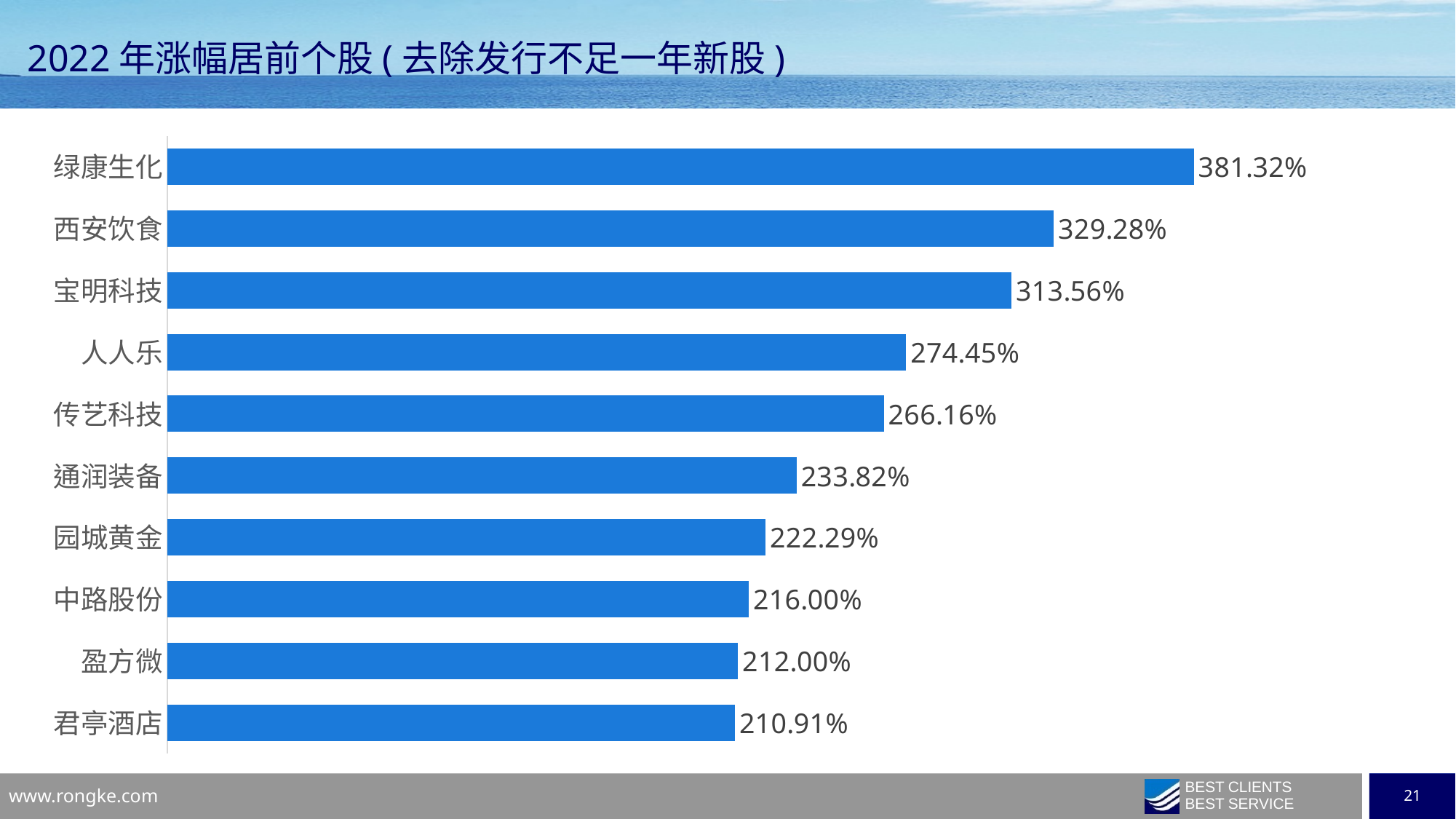
Which stock has the highest value? 绿康生化 What is the value for 君亭酒店? 210.91% Which stock has the lowest value? 君亭酒店 Which is larger, the value for 园城黄金 or the value for 宝明科技? 宝明科技 What kind of chart is shown on the slide? Bar chart What is the title of the chart? 2022 年涨幅居前个股（去除发行不足一年新股） What is the value for 绿康生化? 381.32% How many stocks are shown in the chart? 10 What is the value for 通润装备? 233.82% Which is larger, the value for 人人乐 or the value for 传艺科技? 人人乐 What is the difference between the values for 中路股份 and 盈方微? 4.00% What is the difference between the values for 绿康生化 and 西安饮食? 52.04%